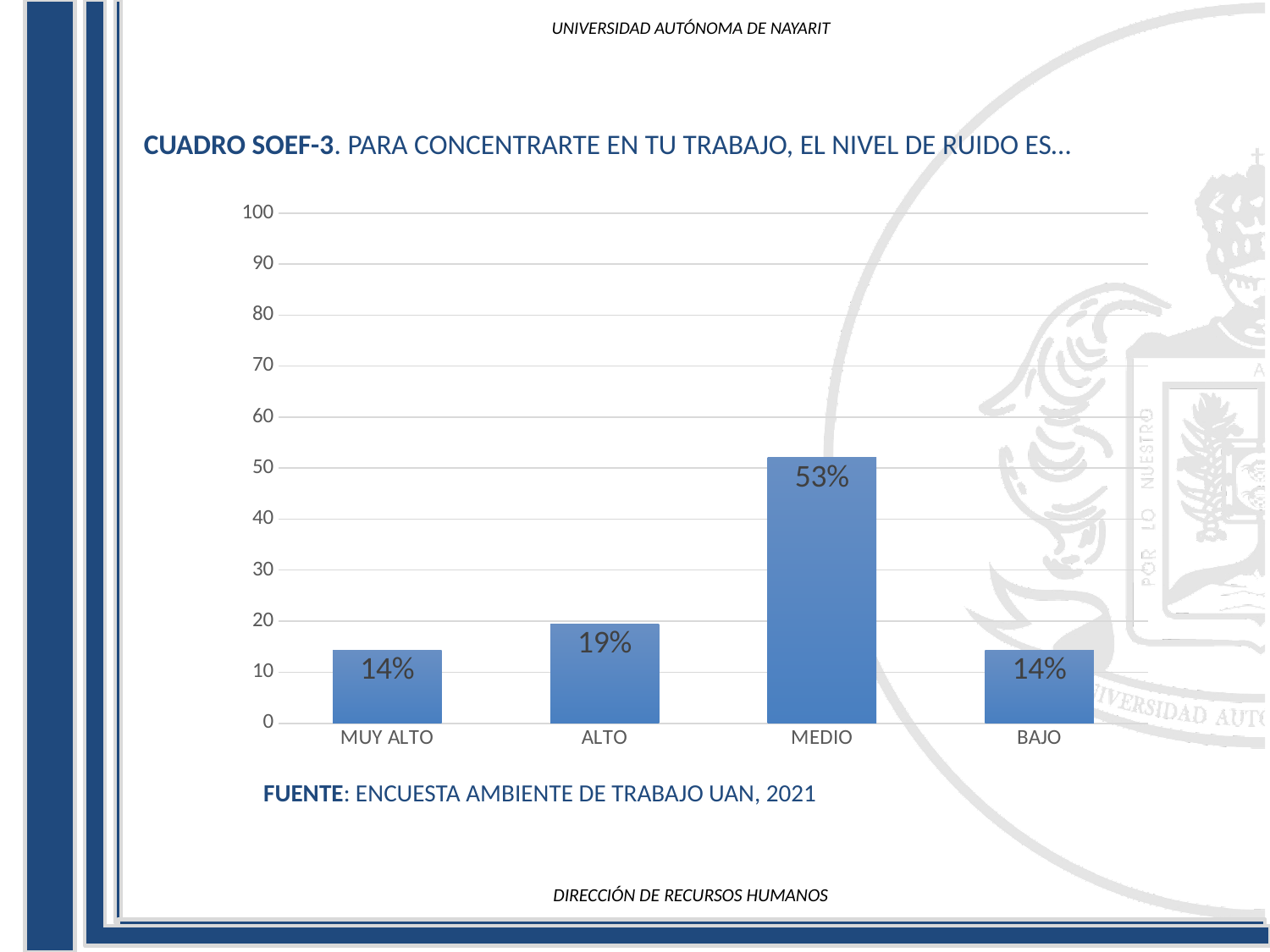
How many categories are shown on the x axis? 4 What is the value for MUY ALTO? 14% What is the difference between the values for ALTO and BAJO? 5% What is the difference between the values for MEDIO and ALTO? 34% Which is larger, the value for ALTO or the value for MUY ALTO? ALTO What is the value for BAJO? 14% What is the source cited below the chart? ENCUESTA AMBIENTE DE TRABAJO UAN, 2021 What is the value for ALTO? 19% What kind of chart is shown on the slide? bar chart Is the value for MEDIO greater or less than 50? greater Which category has the highest value? MEDIO What is the value for MEDIO? 53%